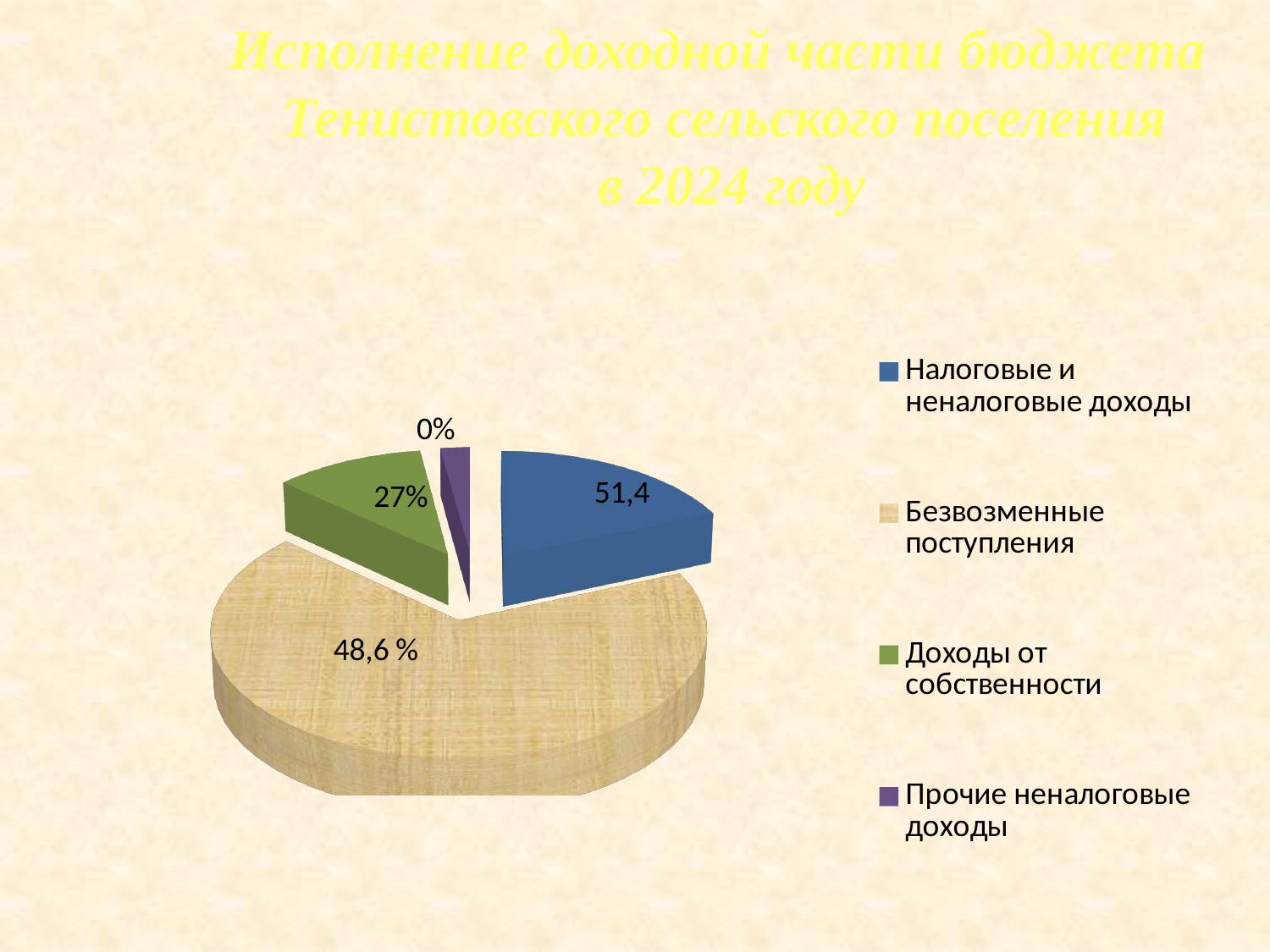
What colour is the slice for "Доходы от собственности"? green What value is shown for the slice "Прочие неналоговые доходы"? 0% Which is larger: the slice for "Налоговые и неналоговые доходы" or the slice for "Доходы от собственности"? Налоговые и неналоговые доходы What value is shown for the slice "Доходы от собственности"? 27% Which is larger: the slice for "Доходы от собственности" or the slice for "Прочие неналоговые доходы"? Доходы от собственности What value is shown for the slice "Налоговые и неналоговые доходы"? 51,4 Which category has the smallest slice of the pie? Прочие неналоговые доходы What kind of chart is shown on the slide? pie chart How many slices does the pie chart have? 4 What value is shown for the slice "Безвозмездные поступления"? 48,6 % What is the title of the slide? Исполнение доходной части бюджета Тенистовского сельского поселения в 2024 году How many entries does the legend list? 4